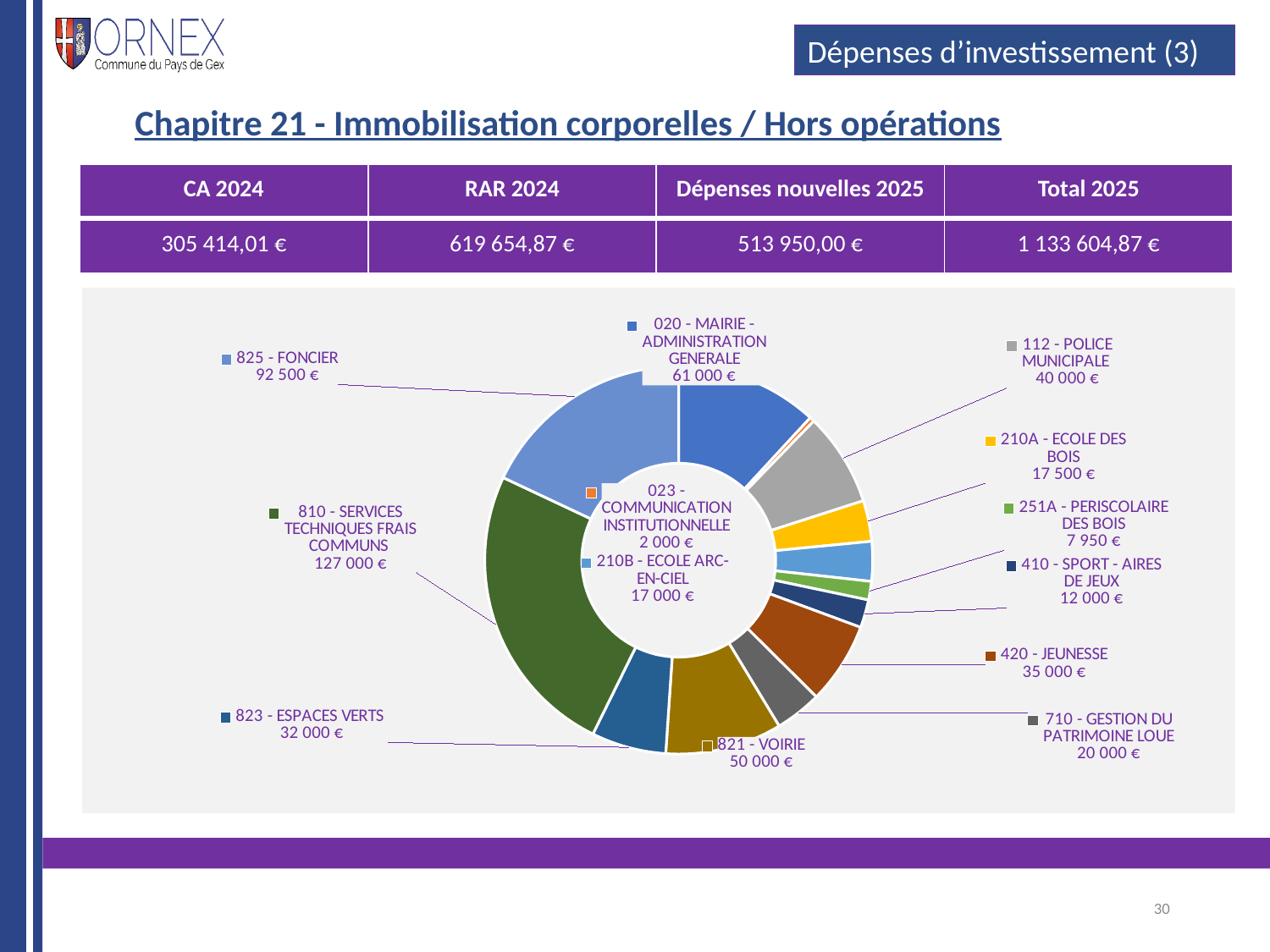
How many categories are shown in the chart? 13 Which category has the lowest value in the chart? 023 - COMMUNICATION INSTITUTIONNELLE Which is larger, the value for 112 - POLICE MUNICIPALE or the value for 823 - ESPACES VERTS? 112 - POLICE MUNICIPALE What is the value for 825 - FONCIER? 92 500 € What is the value for 710 - GESTION DU PATRIMOINE LOUE? 20 000 € What is the value for 251A - PERISCOLAIRE DES BOIS? 7 950 € What is the Total 2025 shown in the table above the chart? 1 133 604,87 € What is the value for 810 - SERVICES TECHNIQUES FRAIS COMMUNS? 127 000 € Which category has the highest value in the chart? 810 - SERVICES TECHNIQUES FRAIS COMMUNS What kind of chart is shown on the slide? Doughnut chart What is the difference between the values for 821 - VOIRIE and 420 - JEUNESSE? 15 000 € What is the difference between the values for 825 - FONCIER and 020 - MAIRIE - ADMINISTRATION GENERALE? 31 500 €